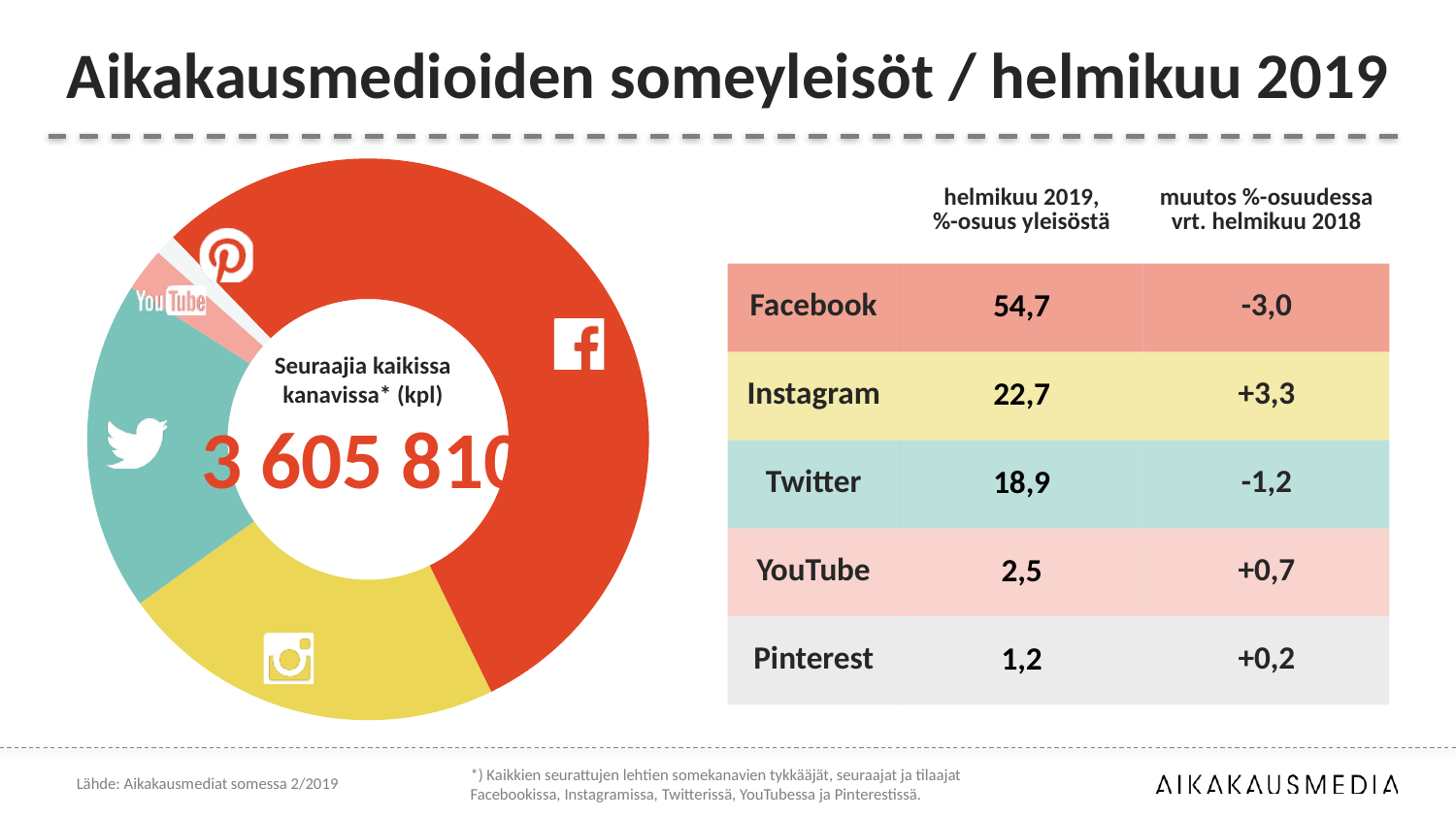
Which channel has the smallest slice of the donut chart? Pinterest What is the change in percentage share for Facebook compared with February 2018? -3,0 According to the slide, what is Instagram's share of the audience in February 2019? 22,7 According to the slide, what is Twitter's share of the audience in February 2019? 18,9 What is the difference in percentage share between Facebook and Instagram in February 2019? 32,0 What kind of chart is shown on the left of the slide? Donut (pie) chart What is the total number of followers across all channels shown in the centre of the donut chart? 3 605 810 According to the slide, what is Facebook's share of the audience in February 2019? 54,7 What is the change in percentage share for Instagram compared with February 2018? +3,3 Which channel has the largest slice of the donut chart? Facebook How many channels are shown in the donut chart? 5 Which has a larger share of the audience, Instagram or Twitter? Instagram